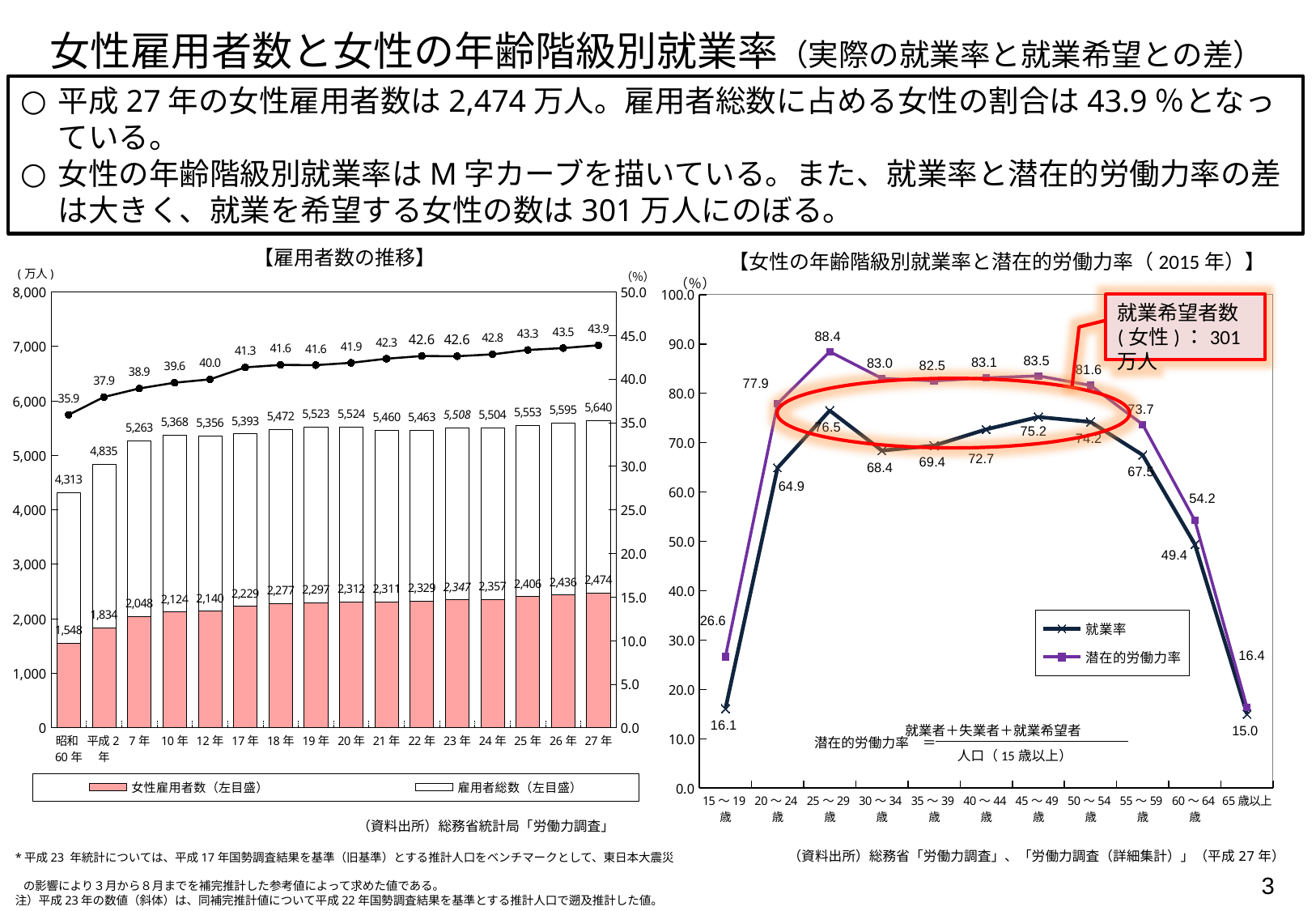
In the 【雇用者数の推移】 chart, how many series does the legend list? 2 In the 【雇用者数の推移】 chart, what is the value of 雇用者総数 for 昭和60年? 4,313 In the 【雇用者数の推移】 chart, what is the value of 女性雇用者数 for 27年? 2,474 In the 【女性の年齢階級別就業率と潜在的労働力率（2015年）】 chart, how many age groups are shown on the x axis? 11 In the 【女性の年齢階級別就業率と潜在的労働力率（2015年）】 chart, what is the 就業率 for 25～29歳? 76.5 In the 【女性の年齢階級別就業率と潜在的労働力率（2015年）】 chart, what is the 潜在的労働力率 for 45～49歳? 83.5 In the 【女性の年齢階級別就業率と潜在的労働力率（2015年）】 chart, what is the difference between 潜在的労働力率 and 就業率 for 30～34歳? 14.6 In the 【女性の年齢階級別就業率と潜在的労働力率（2015年）】 chart, which age group has the lowest 就業率? 65歳以上 In the 【雇用者数の推移】 chart, which year has the highest 雇用者総数? 27年 In the 【雇用者数の推移】 chart, does the percentage line generally rise or fall from 昭和60年 to 27年? rise In the 【雇用者数の推移】 chart, what is the difference between 雇用者総数 and 女性雇用者数 for 27年? 3,166 In the 【雇用者数の推移】 chart, what is the percentage shown on the line for 平成2年? 37.9